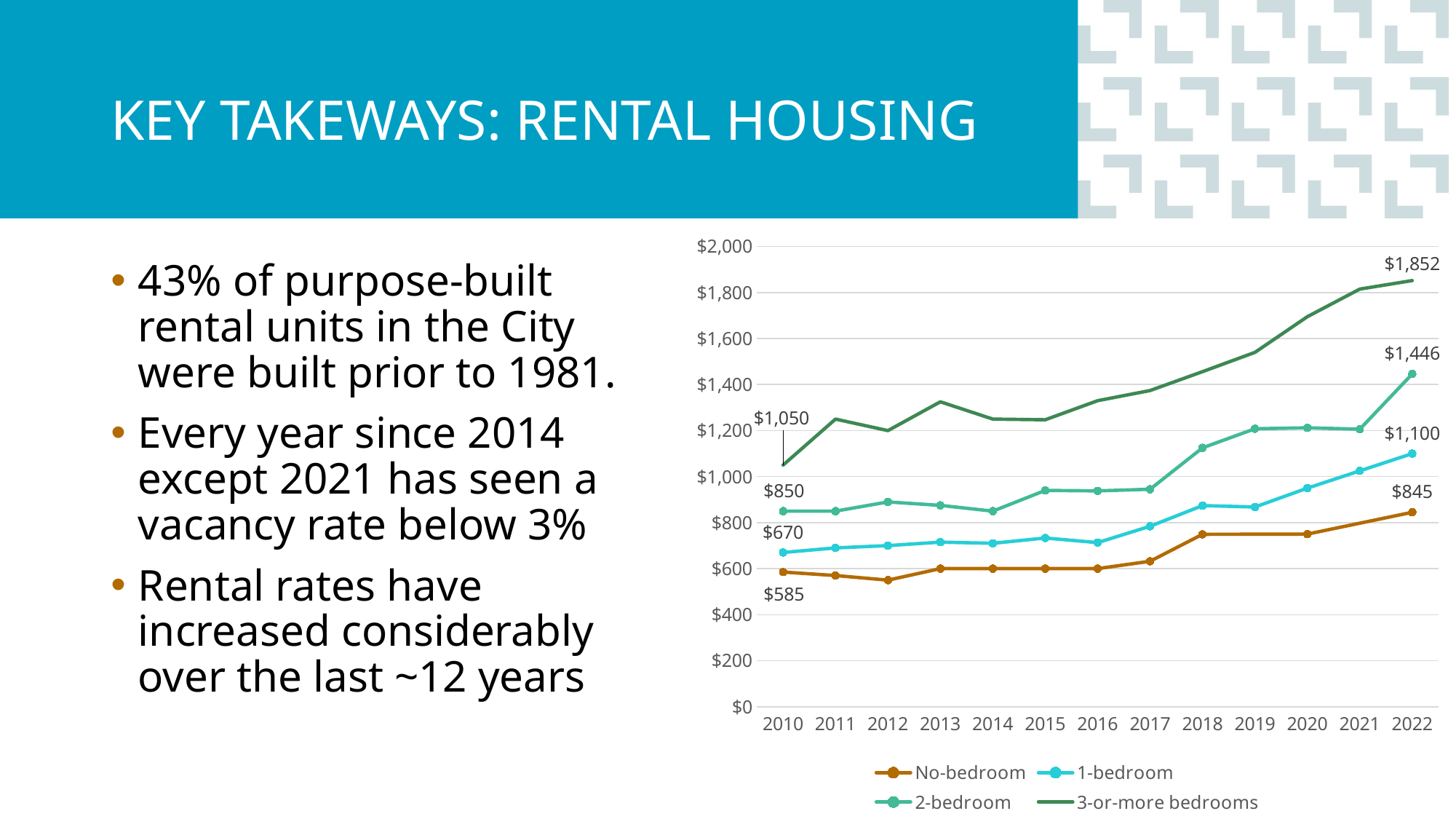
What type of chart is shown on the slide? line chart Which is larger in 2022: the 2-bedroom rate or the 1-bedroom rate? 2-bedroom How many series does the chart legend list? 4 Is the value for 3-or-more bedrooms in 2019 greater or less than $1,400? greater What was the rental rate for a 1-bedroom unit in 2010? $670 How many years are shown on the x axis of the chart? 13 What was the rental rate for a No-bedroom unit in 2010? $585 By how much did the 1-bedroom rental rate increase from 2010 to 2022? $430 What was the rental rate for a 2-bedroom unit in 2022? $1,446 What was the rental rate for 3-or-more bedrooms in 2022? $1,852 Does the 3-or-more bedrooms series generally rise or fall from 2010 to 2022? rise Which series has the highest value in 2022? 3-or-more bedrooms